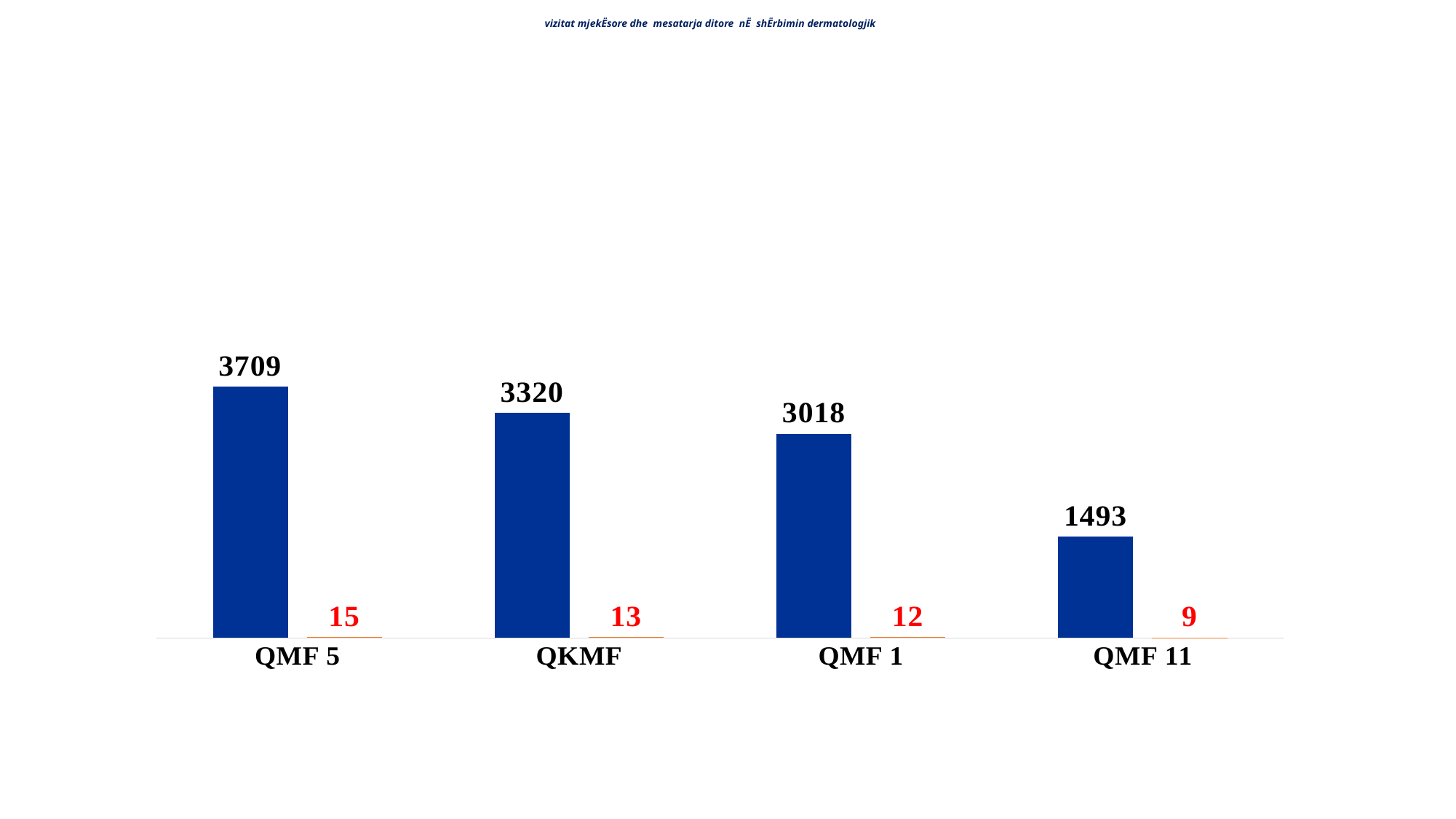
What is the value of the blue bar for QMF 11? 1493 What kind of chart is shown on the slide? bar chart How many categories are shown on the x axis? 4 Do the blue bar values rise or fall from left to right across the categories? fall Which has a larger blue bar value, QMF 1 or QMF 11? QMF 1 Which category has the lowest blue bar? QMF 11 What is the difference between the blue bar values for QMF 5 and QKMF? 389 What is the value of the blue bar for QMF 5? 3709 What is the red-labelled value shown for QMF 11? 9 What is the red-labelled value shown for QMF 1? 12 What is the value of the blue bar for QKMF? 3320 Which category has the highest blue bar? QMF 5